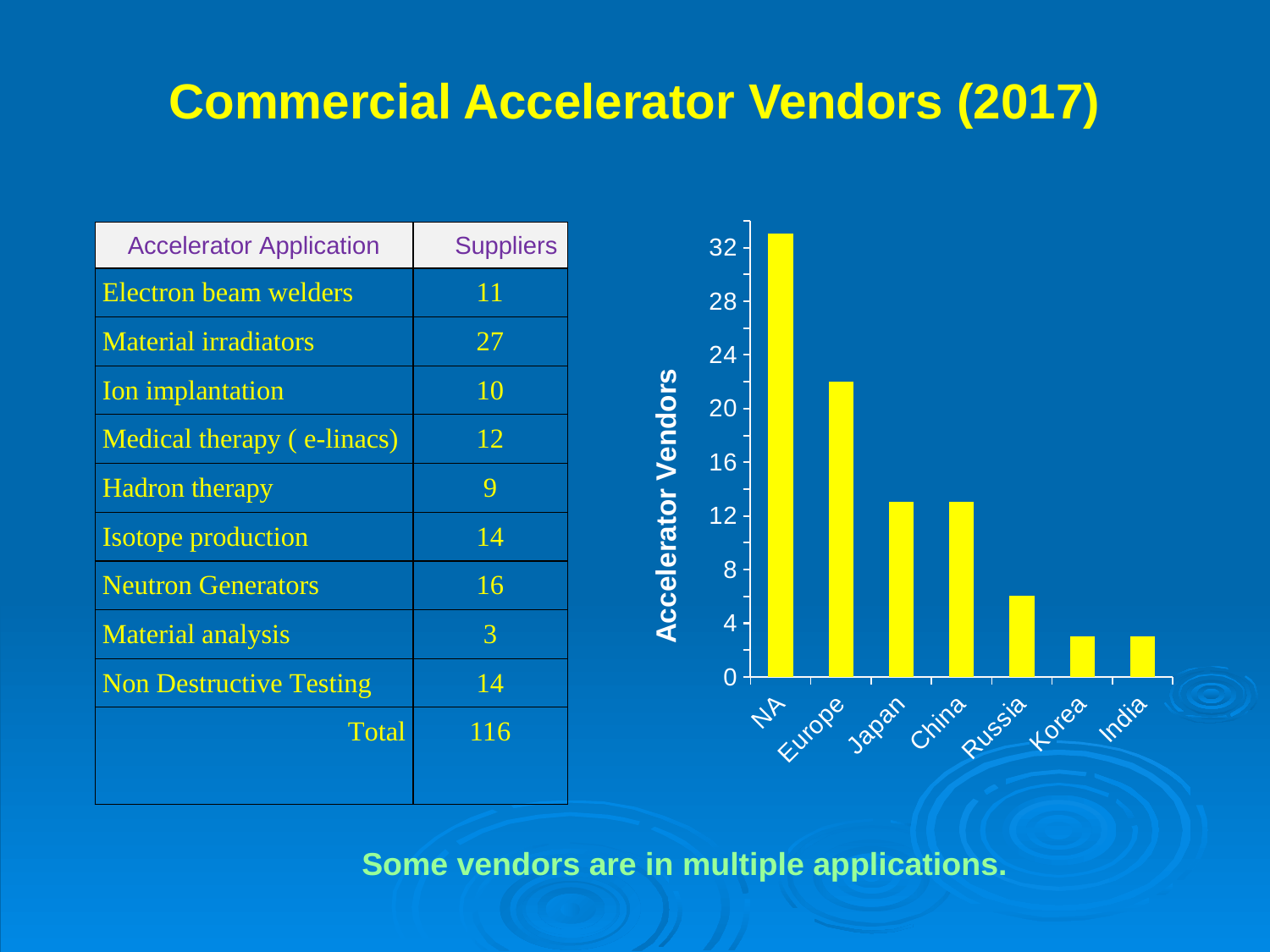
Is the value for Europe greater or less than 20? greater What kind of chart is shown on the slide? bar chart Which has more accelerator vendors, Japan or Russia? Japan Is the value for NA greater or less than 28? greater How many countries or regions are shown on the x axis of the chart? 7 Is the value for Europe greater or less than 24? less Which country or region has the highest number of accelerator vendors in the chart? NA Which has more accelerator vendors, NA or Europe? NA What is the label on the vertical axis of the chart? Accelerator Vendors